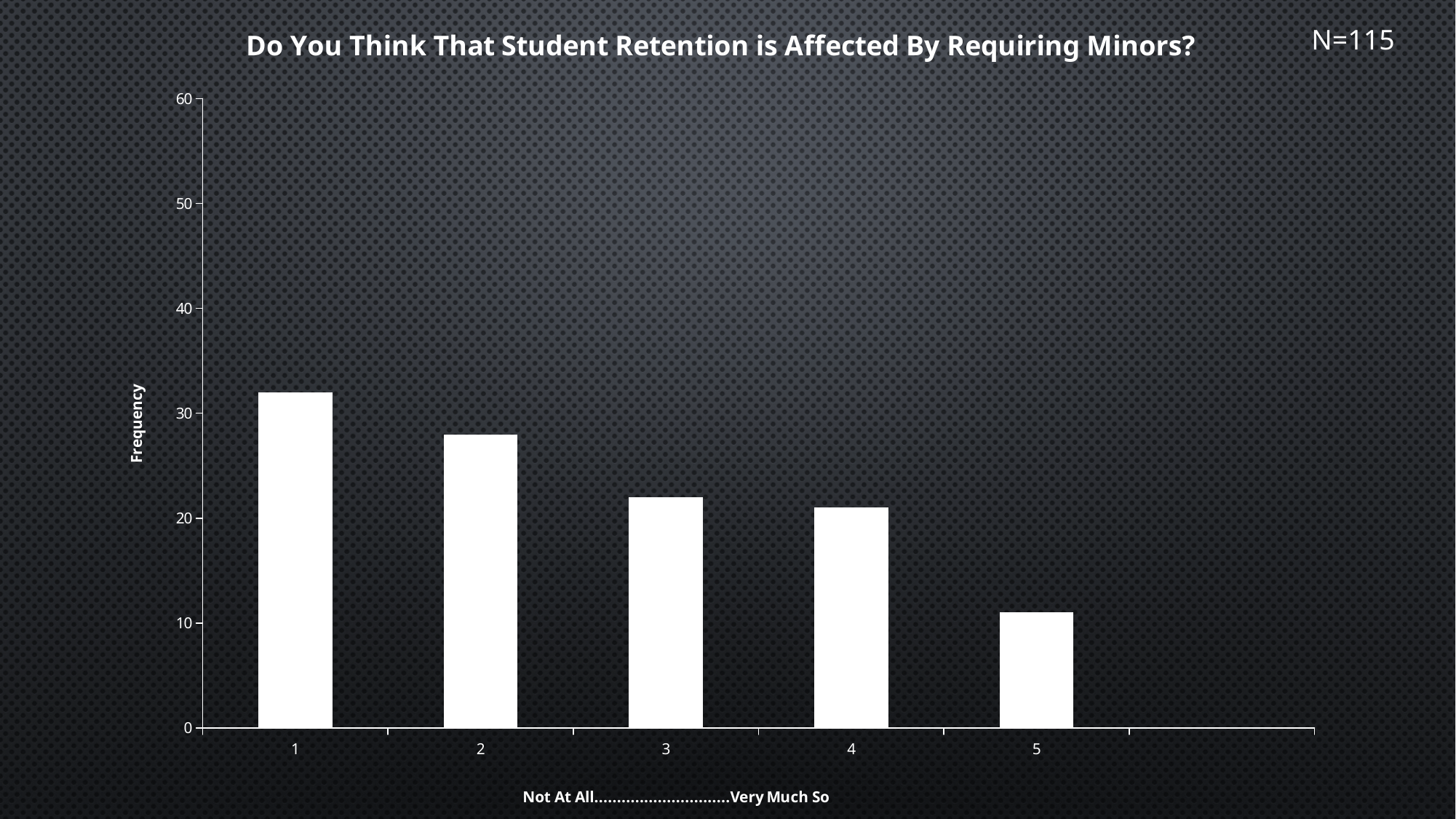
What is the title of the chart? Do You Think That Student Retention is Affected By Requiring Minors? Is the frequency for category 5 greater or less than 20? less Which category has the lowest frequency? 5 Is the frequency for category 3 greater or less than 20? greater What is the label on the vertical axis of the chart? Frequency Is the frequency for category 2 greater or less than 30? less Do the frequencies rise or fall as you move from category 1 to category 5 along the x axis? fall Which category has the highest frequency? 1 Which has a higher frequency, category 1 or category 2? 1 What kind of chart is shown on the slide? bar chart How many bars (categories) are plotted in the chart? 5